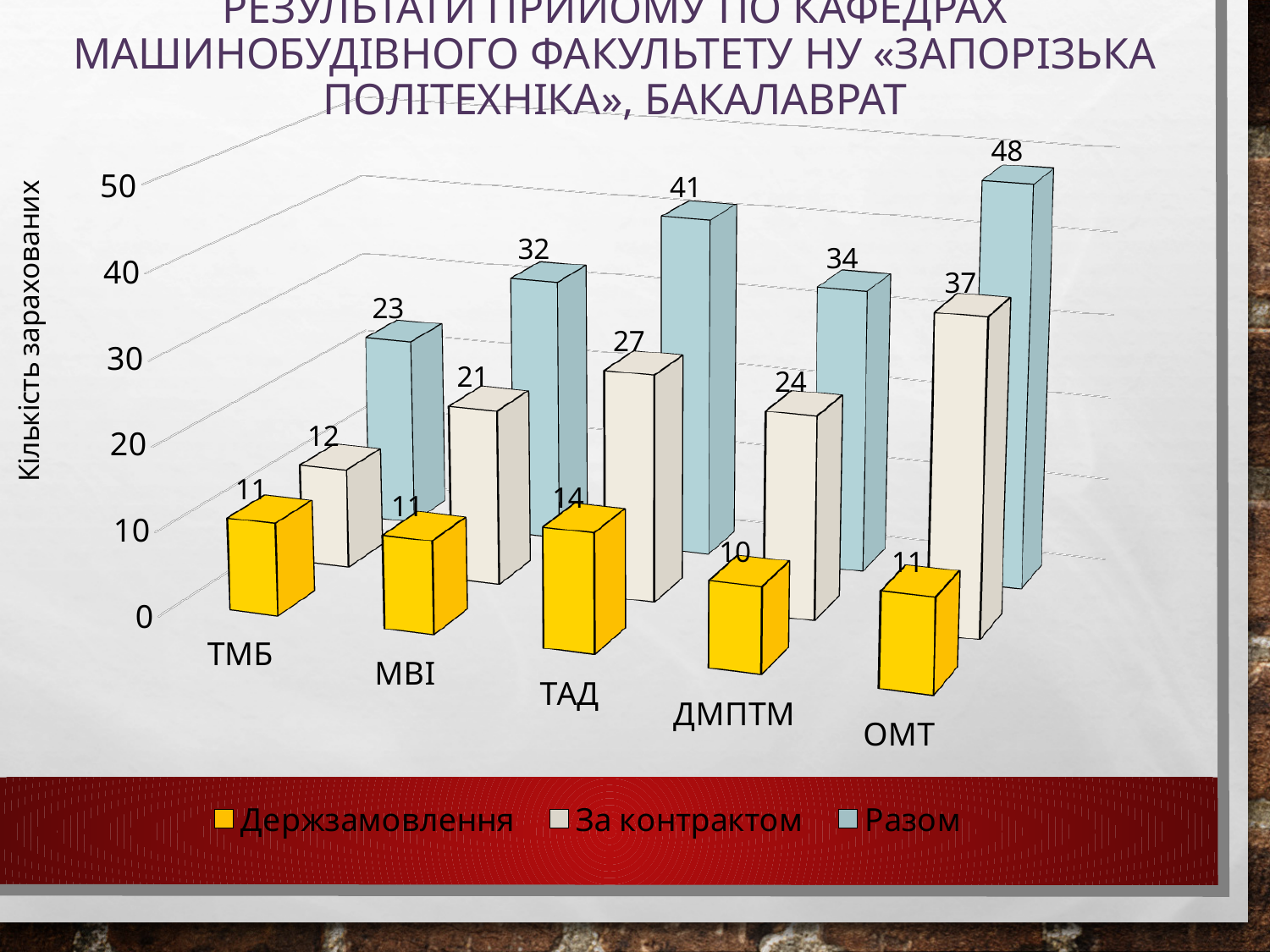
What is the value of За контрактом for ТАД? 27 What is the value of Держзамовлення for ДМПТМ? 10 Which is larger: За контрактом for МВІ or За контрактом for ДМПТМ? ДМПТМ What is the difference between the Разом values for ОМТ and ТМБ? 25 Which category has the lowest За контрактом value? ТМБ What is the value of Разом for ОМТ? 48 How many categories are shown on the x axis? 5 How many series does the legend list? 3 What kind of chart is shown on the slide? Bar chart Which series is shown in yellow in the legend? Держзамовлення What is the label of the vertical axis? Кількість зарахованих Which category has the highest Разом value? ОМТ